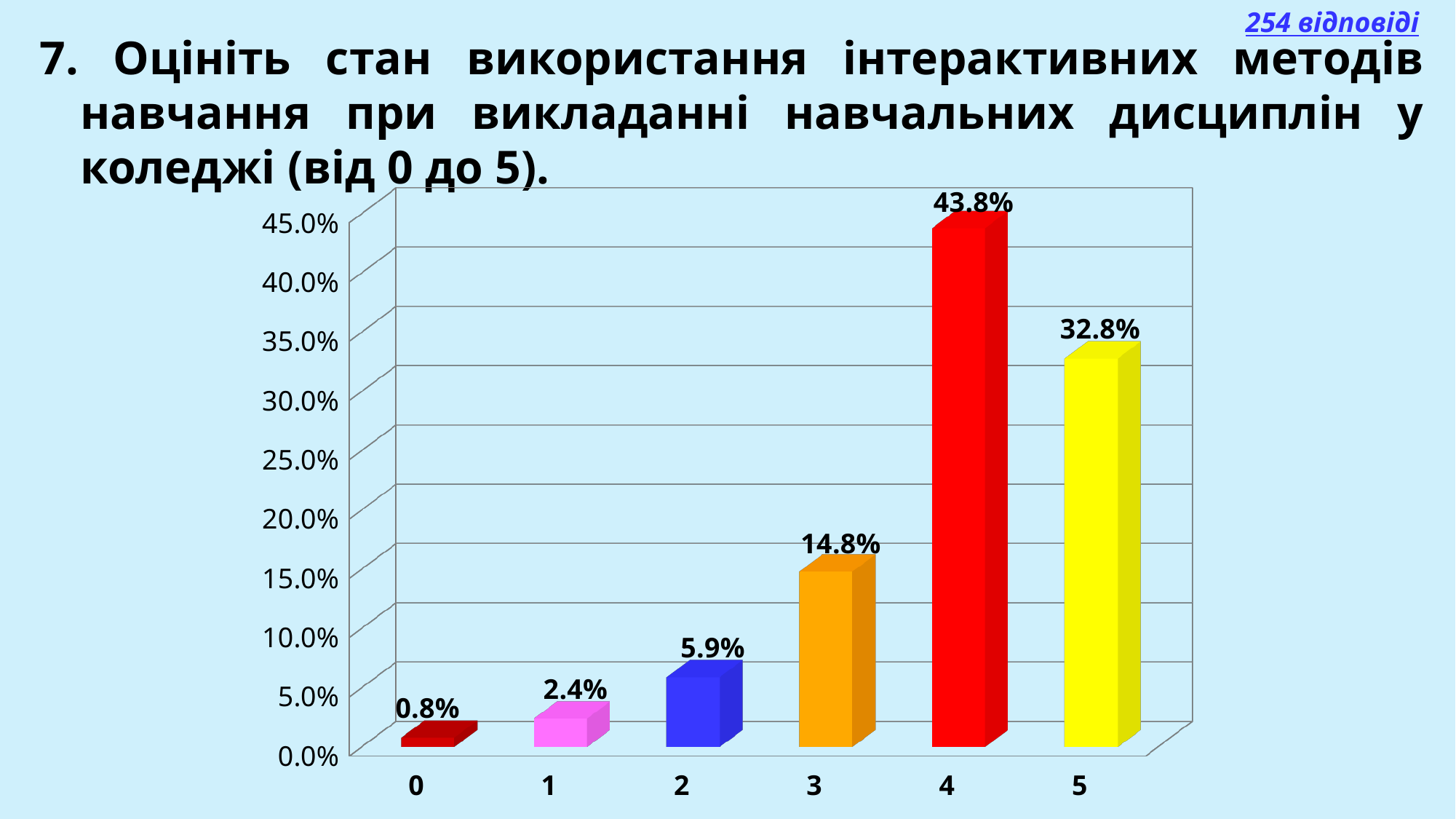
Which category has the lowest value? 0 Which category has the highest value? 4 What is the difference between the values for category 4 and category 5? 11.0% Is the value for category 5 greater or less than 30.0%? greater What is the difference between the values for category 3 and category 2? 8.9% Which is larger, the value for category 5 or the value for category 3? 5 What kind of chart is shown on the slide? bar chart What is the value for category 4? 43.8% How many categories are shown on the x axis? 6 What colour is the bar for category 4? red What is the value for category 0? 0.8% What is the value for category 3? 14.8%